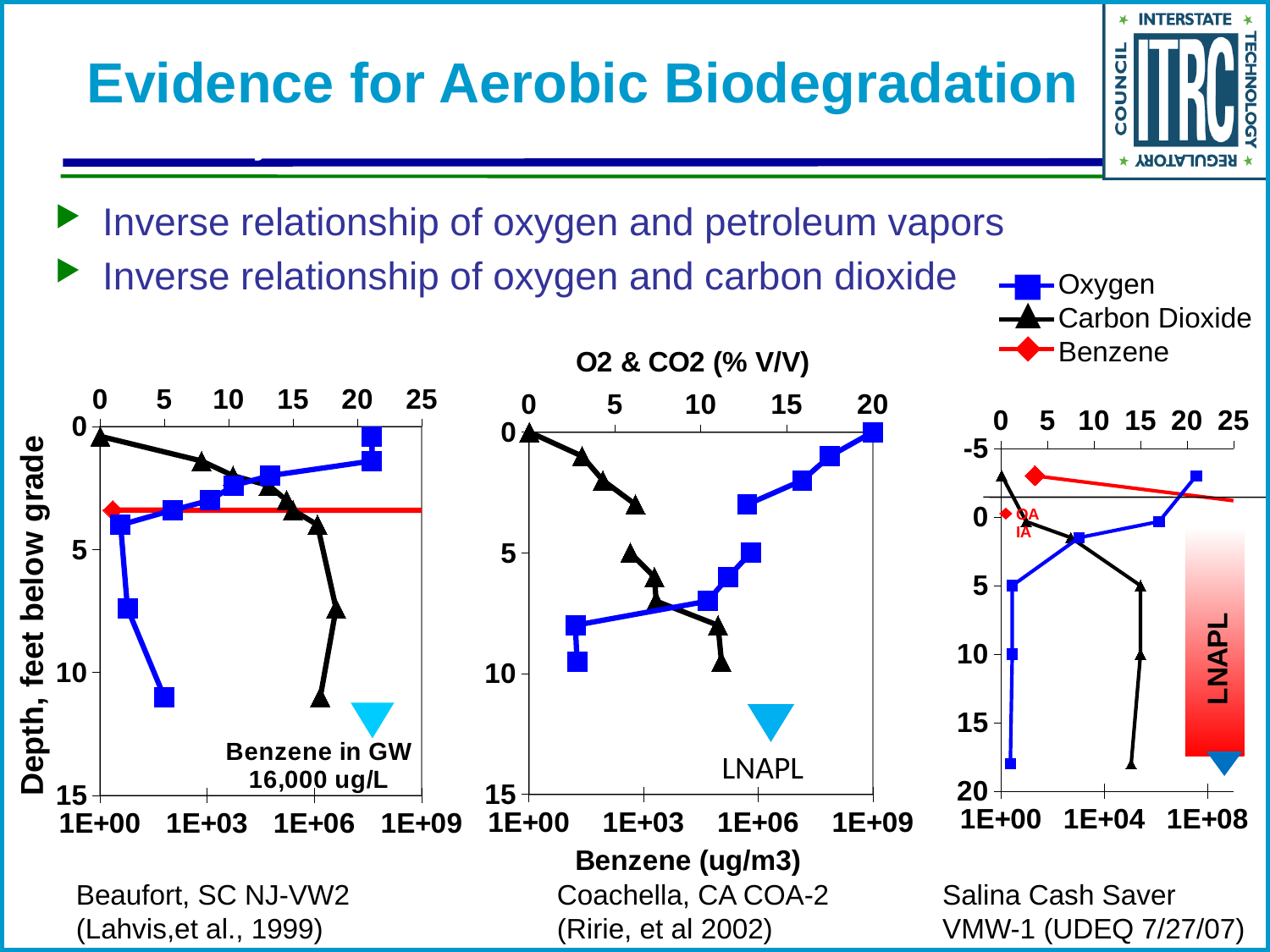
What kind of chart is the middle chart (Coachella, CA COA-2)? Line chart In the middle chart (Coachella, CA COA-2), does the Carbon Dioxide value rise or fall as depth increases? Rise In the left chart (Beaufort, SC NJ-VW2), at a depth of about 7.5 feet, which is larger: Oxygen or Carbon Dioxide? Carbon Dioxide In the right chart (Salina Cash Saver VMW-1), is the Oxygen value at a depth of 5 feet greater or less than 5? less In the middle chart (Coachella, CA COA-2), is the Oxygen value at a depth of 5 feet greater or less than 10? greater In the left chart (Beaufort, SC NJ-VW2), is the Carbon Dioxide value at a depth of about 7.5 feet greater or less than 15? greater In the middle chart (Coachella, CA COA-2), does the Oxygen value rise or fall as depth increases? Fall What is the title printed above the middle chart (Coachella, CA COA-2)? O2 & CO2 (% V/V) How many series does the legend list for the charts on this slide? 3 Which series is drawn in red according to the legend? Benzene How many charts are shown on the slide? 3